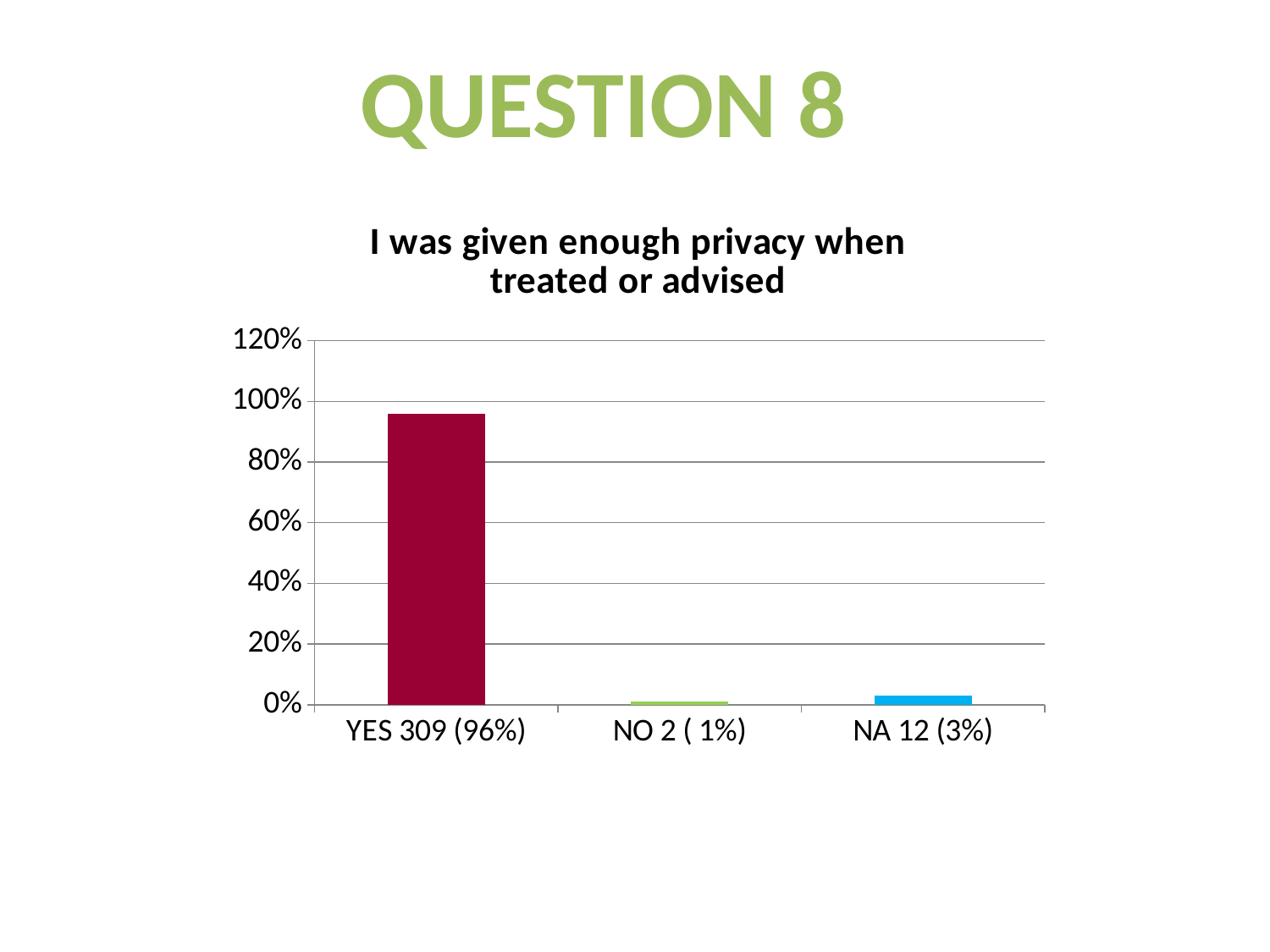
What percentage of respondents answered NA? 3% How many respondents answered NA? 12 Which category has the lowest value? NO What percentage of respondents answered YES? 96% What percentage of respondents answered NO? 1% Which category has the highest value? YES What kind of chart is shown on the slide? bar chart How many categories are shown on the x axis? 3 What is the title of the chart? I was given enough privacy when treated or advised What is the difference in percentage points between YES and NA? 93 Is the value for YES greater or less than 80%? greater How many respondents answered YES? 309